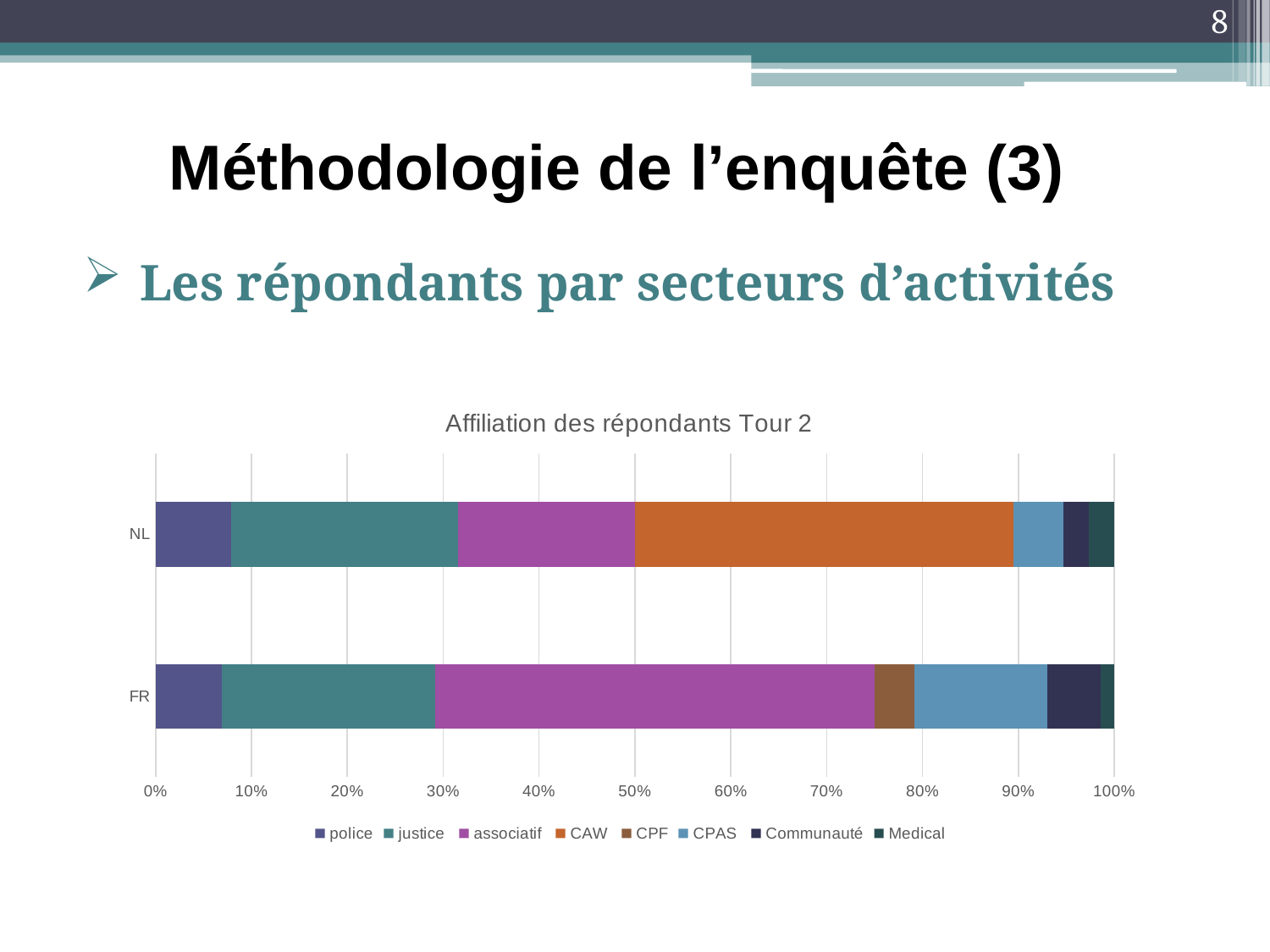
Which series takes up the largest share of the NL bar? CAW Which series takes up the smallest share of the FR bar? Medical Which series is listed first in the legend? police Is the share of CPAS larger for NL or for FR? FR What type of chart is shown on the slide? Stacked bar chart Is the share of CAW in the NL bar greater or less than 30%? greater Which series takes up the largest share of the FR bar? associatif How many series does the legend list? 8 Is the share of CAW larger for NL or for FR? NL How many categories (bars) are shown on the chart? 2 What is the title of the chart? Affiliation des répondants Tour 2 Is the share of associatif larger for NL or for FR? FR